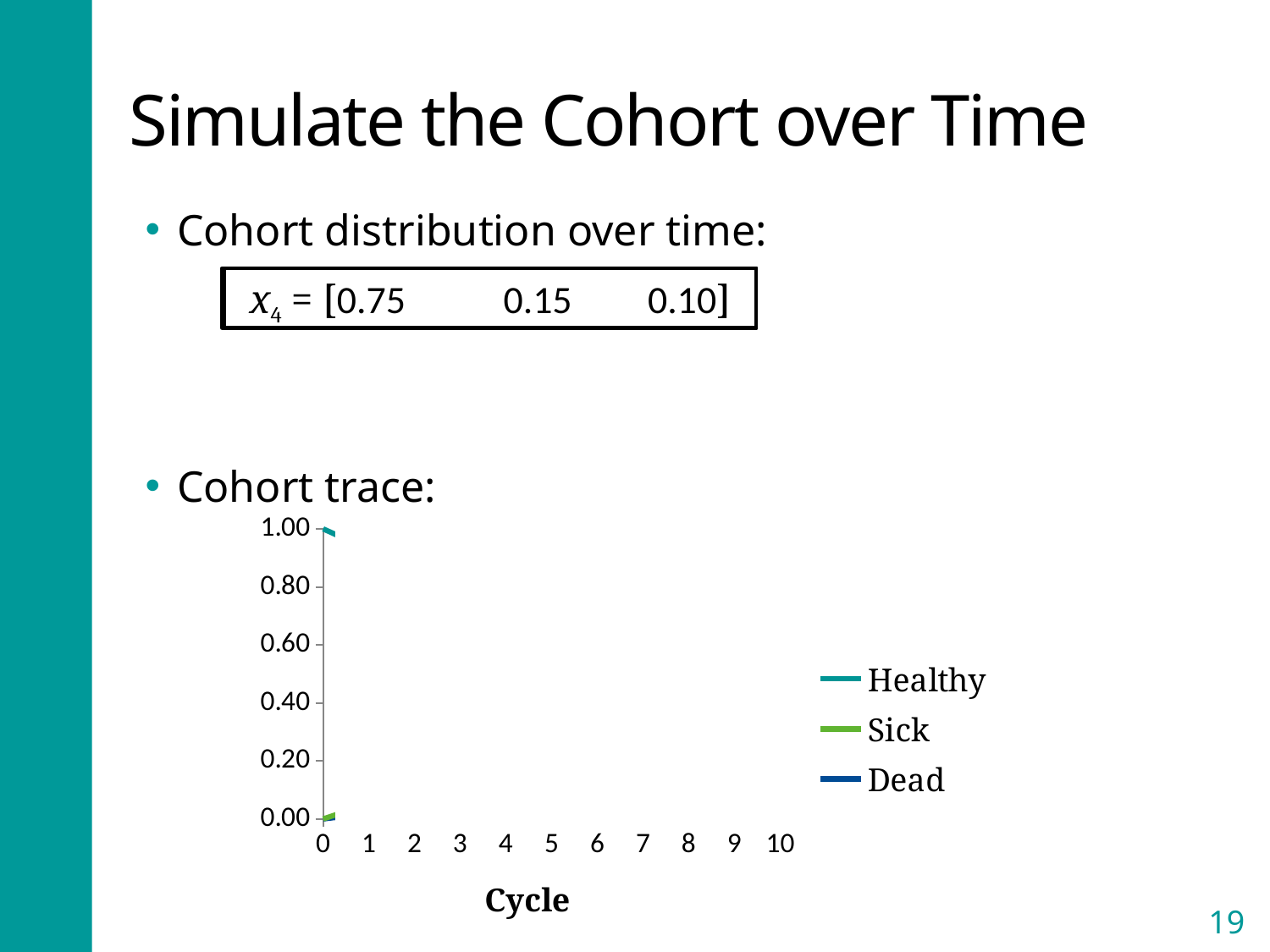
What kind of chart is shown under "Cohort trace"? line chart How many cycle values are labelled on the x axis of the cohort trace chart? 11 What is the title of the x axis of the cohort trace chart? Cycle What is the highest value labelled on the y axis of the cohort trace chart? 1.00 In the cohort trace chart, is the value for Healthy at cycle 0 greater or less than 0.80? greater In the cohort trace chart, which series has the larger value at cycle 0, Healthy or Sick? Healthy In the cohort trace chart, which series has the highest value at cycle 0? Healthy What are the series names listed in the legend of the cohort trace chart? Healthy, Sick, Dead How many series does the legend of the cohort trace chart list? 3 In the cohort trace chart, is the value for Sick at cycle 0 greater or less than 0.20? less